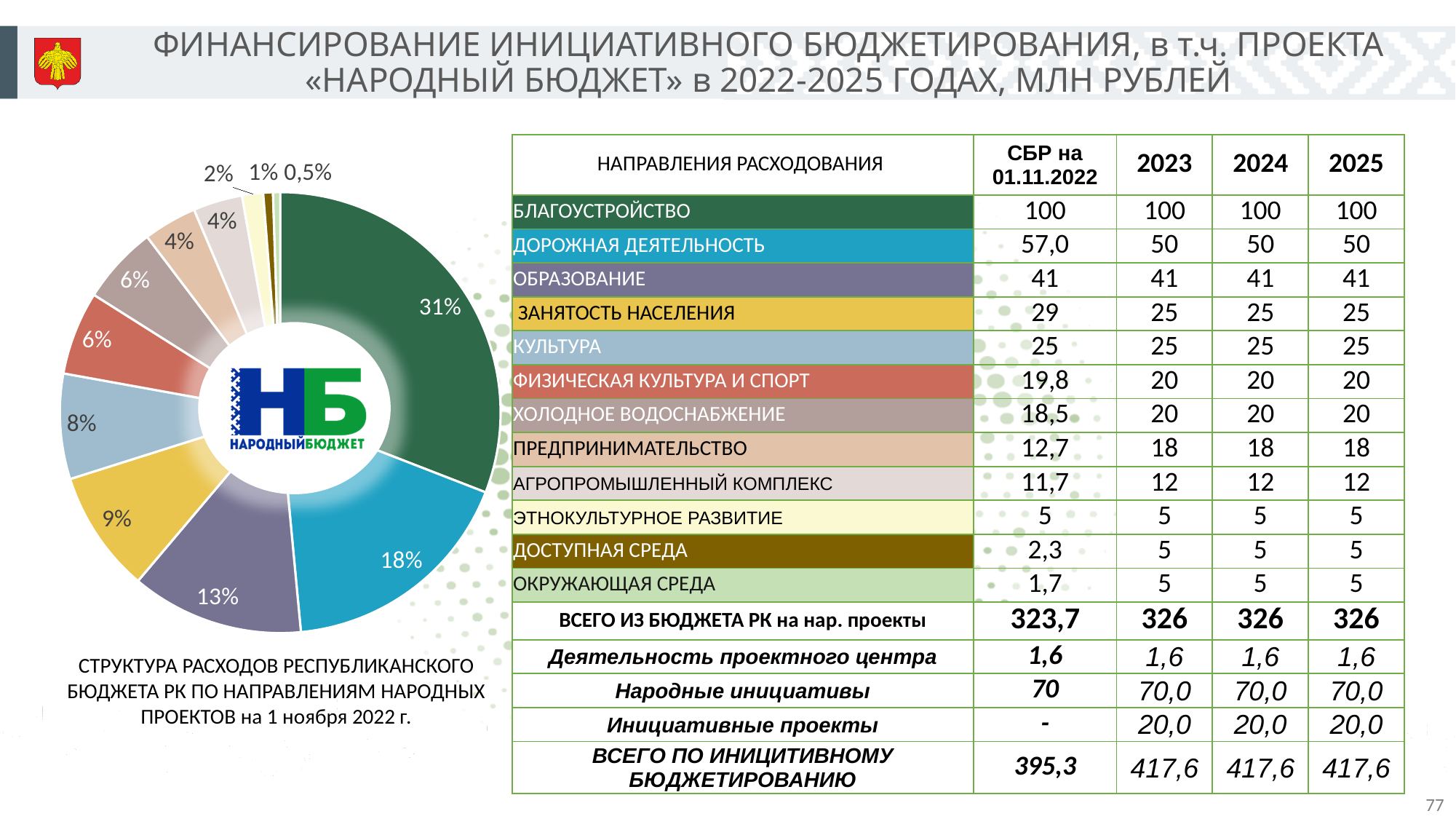
How many slices does the pie chart have? 12 What share does the purple slice (ОБРАЗОВАНИЕ) have in the pie chart? 13% What share does the yellow slice (ЗАНЯТОСТЬ НАСЕЛЕНИЯ) have in the pie chart? 9% What is the smallest share shown in the pie chart? 0,5% What date does the caption under the pie chart say the expenditure structure refers to? 1 ноября 2022 г. Which slice is larger in the pie chart: the purple one (ОБРАЗОВАНИЕ) or the yellow one (ЗАНЯТОСТЬ НАСЕЛЕНИЯ)? the purple one (ОБРАЗОВАНИЕ) What kind of chart is shown on the left of the slide? pie chart What share does the dark green slice (БЛАГОУСТРОЙСТВО) have in the pie chart? 31% What is the largest share shown in the pie chart? 31% By how many percentage points does the largest slice (31%) exceed the second largest slice (18%) in the pie chart? 13